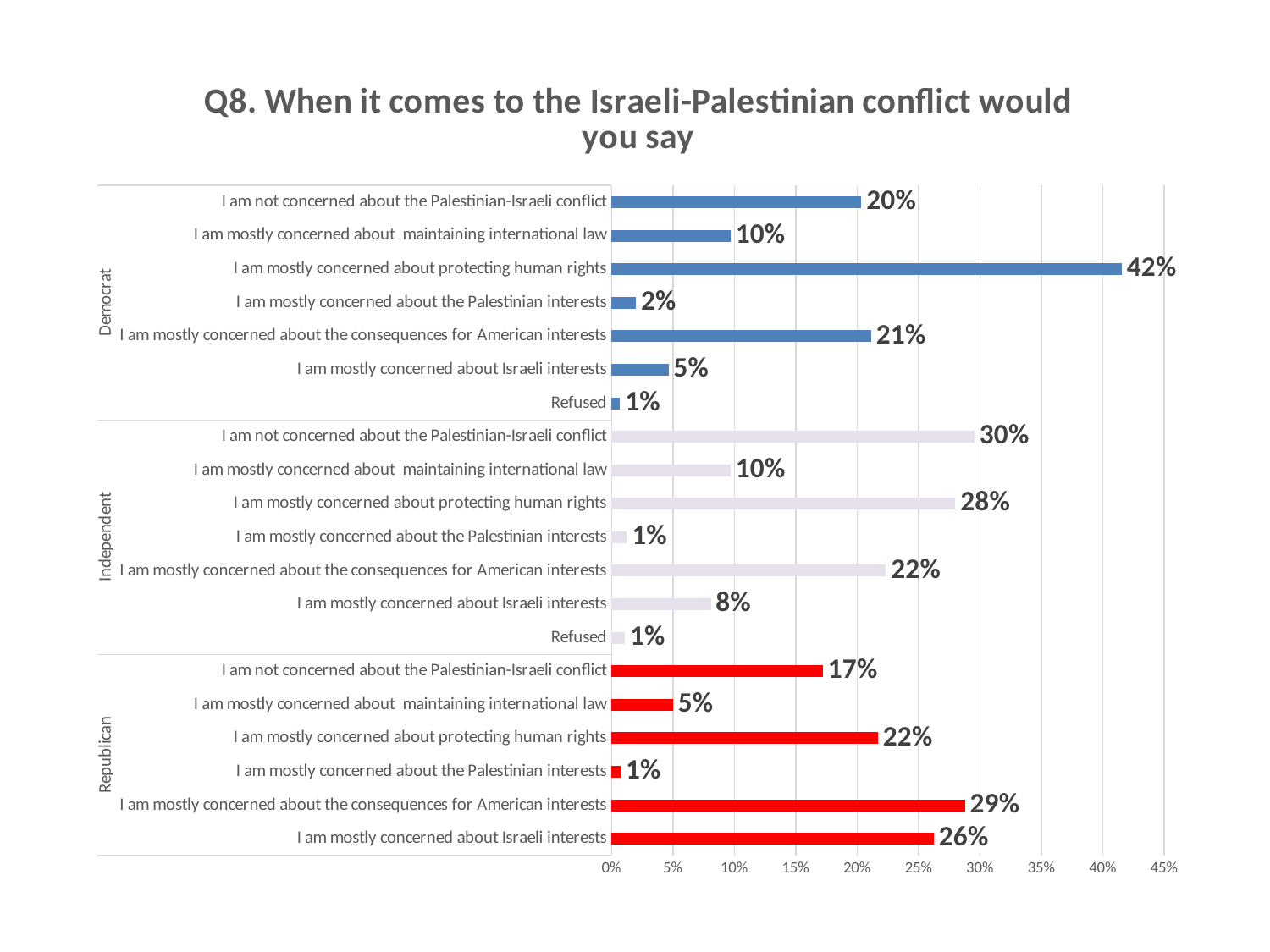
How many response categories are shown for the Republican group? 6 What colour are the bars for the Republican group? Red What percentage of Democrats say they are mostly concerned about protecting human rights? 42% Is the Independent value for 'I am mostly concerned about protecting human rights' greater or less than 25%? greater What percentage of Republicans say they are mostly concerned about Israeli interests? 26% What is the difference between the Democrat and Republican values for 'I am mostly concerned about protecting human rights'? 20% What percentage of Independents say they are not concerned about the Palestinian-Israeli conflict? 30% Which group has a larger value for 'I am mostly concerned about Israeli interests', Democrats or Republicans? Republicans Which response has the highest value among Republicans? I am mostly concerned about the consequences for American interests What kind of chart is shown on the slide? Bar chart Which response has the highest value among Democrats? I am mostly concerned about protecting human rights What is the difference between the Independent and Republican values for 'I am mostly concerned about maintaining international law'? 5%